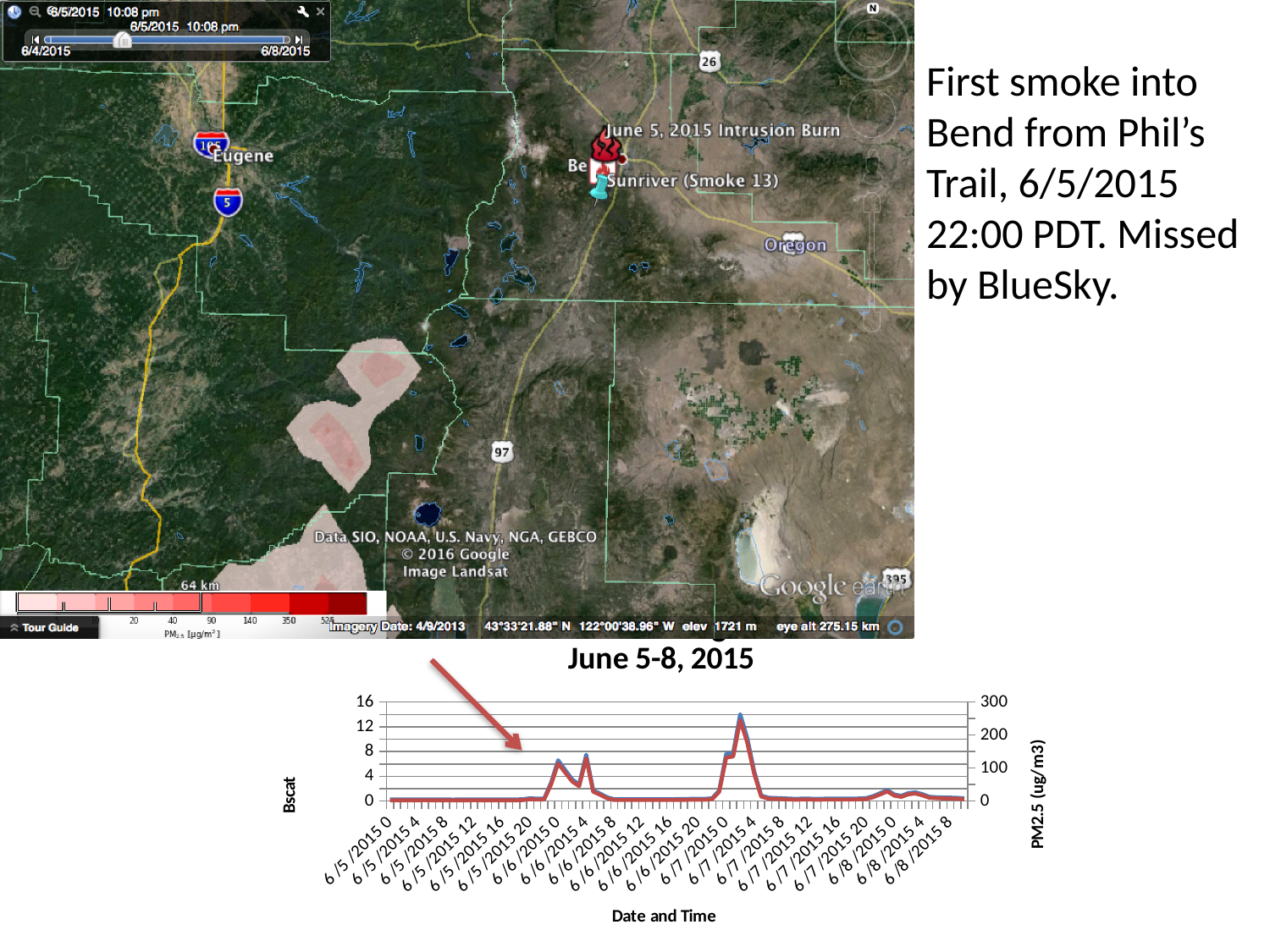
Is the Bscat value at 6/5/2015 0 greater or less than 4? less Is the Bscat value at the highest peak (around 6/7/2015 4) greater or less than 12? greater How many lines are plotted on the chart? 2 Is the PM2.5 value at the highest peak (around 6/7/2015 4) greater or less than 200? greater How many tick labels are shown on the x axis of the chart? 21 What kind of chart is shown at the bottom of the slide? line chart What is the title of the chart at the bottom of the slide? June 5-8, 2015 Between 6/7/2015 4 and 6/7/2015 8, do the values rise or fall? fall Which peak is higher: the one around 6/6/2015 0 or the one around 6/7/2015 4? 6/7/2015 4 On which date does the highest peak of the chart occur? 6/7/2015 What is the label of the x axis of the chart? Date and Time